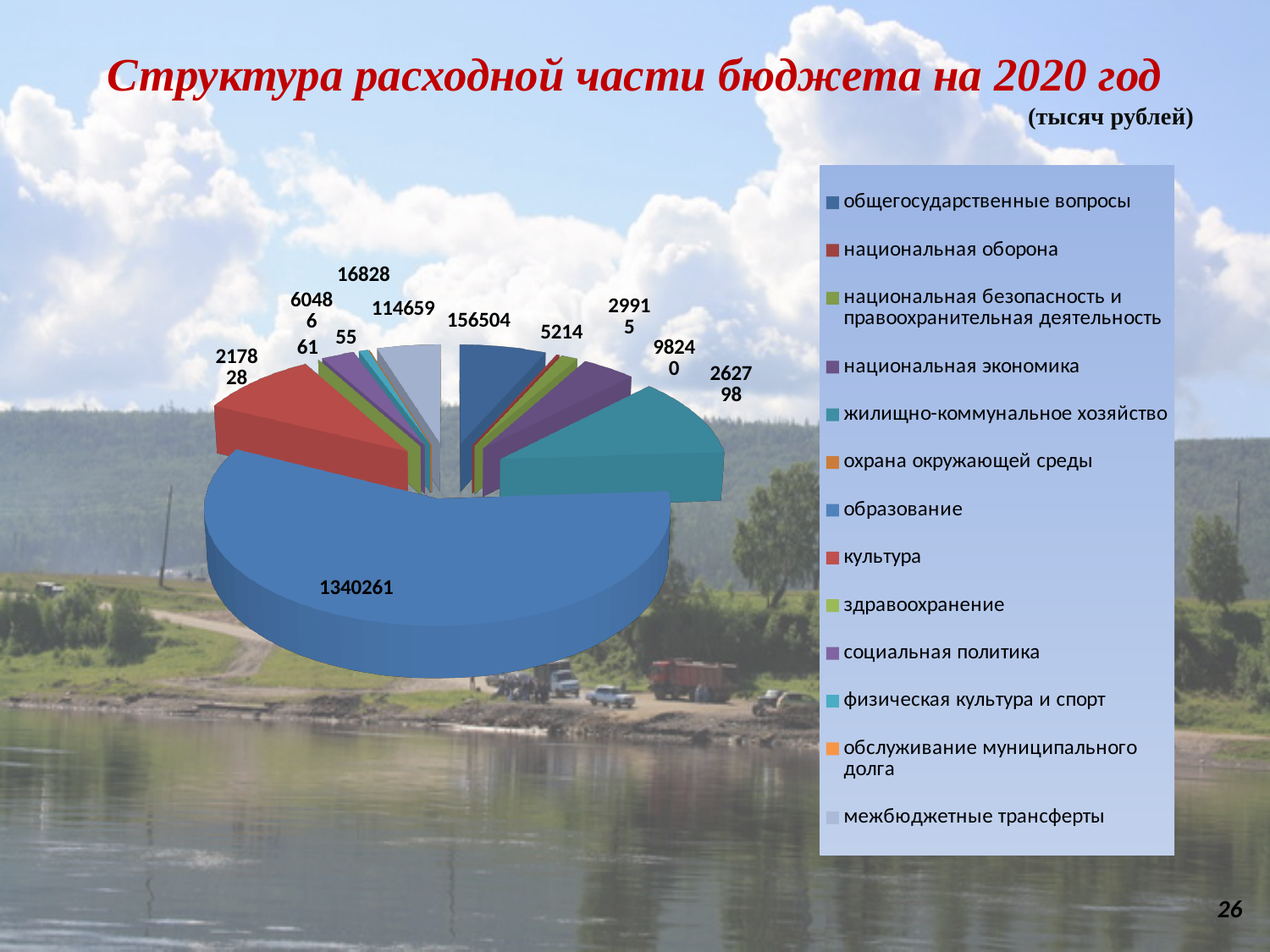
What is the title of the chart on the slide? Структура расходной части бюджета на 2020 год What is the difference between the values for жилищно-коммунальное хозяйство and культура? 44970 What is the value shown for культура? 217828 In what units are the chart values given, according to the slide? тысяч рублей What is the value shown for жилищно-коммунальное хозяйство? 262798 What is the difference between the values for образование and жилищно-коммунальное хозяйство? 1077463 How many entries does the chart legend list? 13 What is the value shown for образование? 1340261 What is the value shown for общегосударственные вопросы? 156504 What kind of chart is shown on the slide? pie chart Which is larger, the value for образование or the value for жилищно-коммунальное хозяйство? образование Which category has the largest slice of the pie? образование